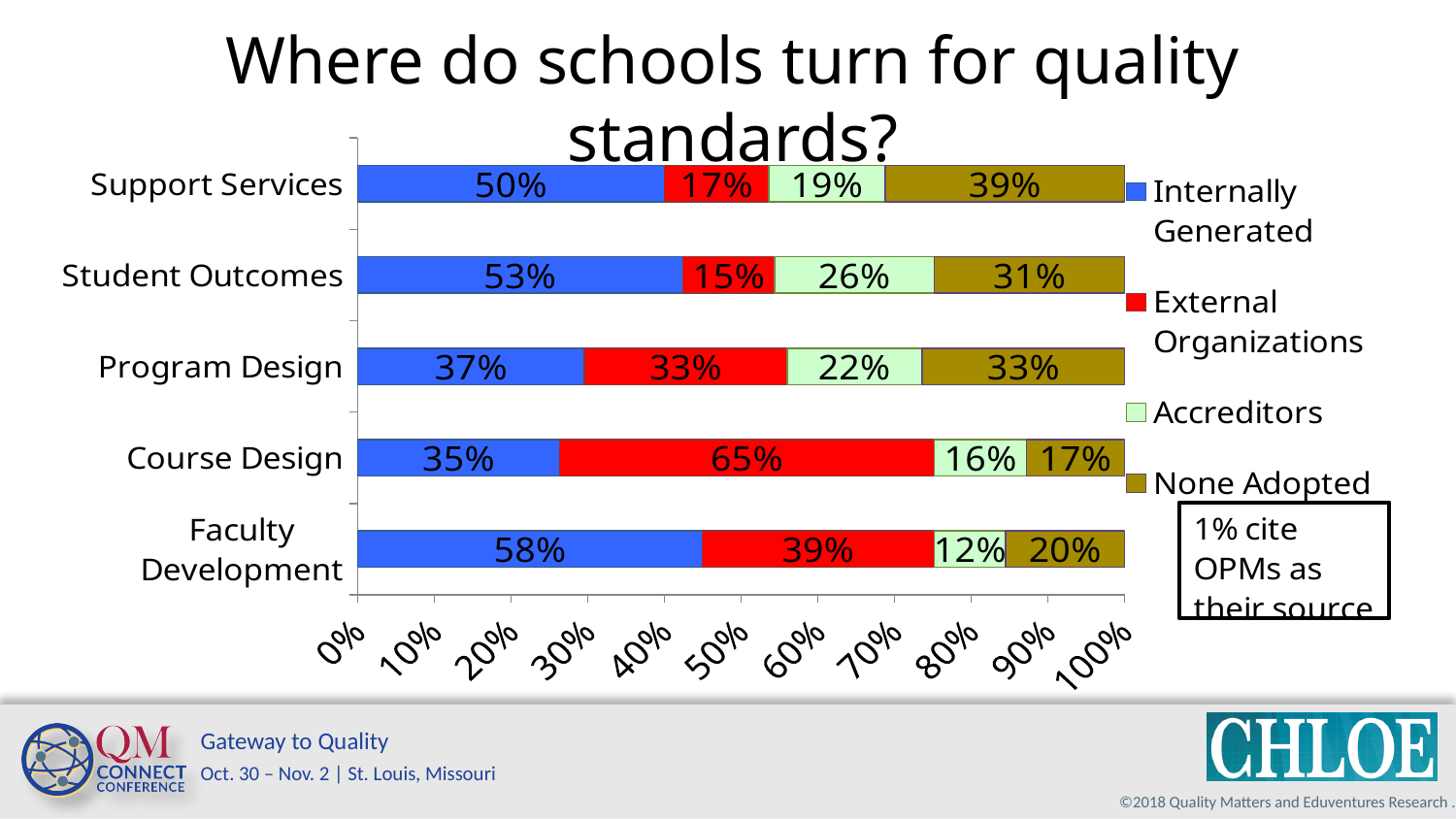
What is the Internally Generated value for Faculty Development? 58% What kind of chart is shown on the slide? Stacked bar chart What is the difference between the External Organizations values for Course Design and Program Design? 32% What is the None Adopted value for Support Services? 39% Which is larger: the None Adopted value for Student Outcomes or for Course Design? Student Outcomes How many categories are plotted on the chart? 5 How many series does the legend list? 4 What is the title of the chart? Where do schools turn for quality standards? Which category has the highest Internally Generated value? Faculty Development What is the Accreditors value for Student Outcomes? 26% Which category has the lowest Accreditors value? Faculty Development What is the External Organizations value for Course Design? 65%